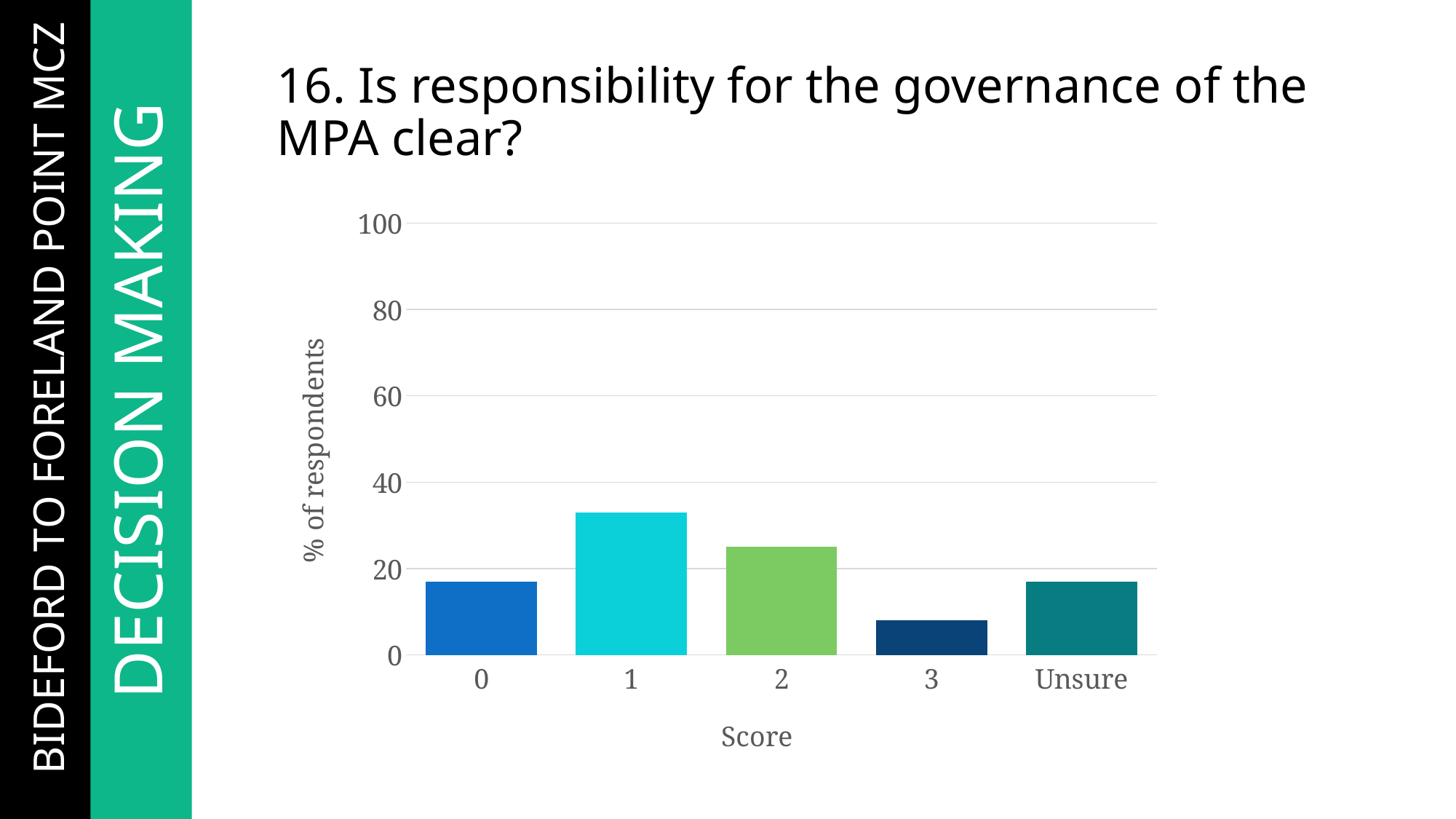
What is the label of the y axis of the chart? % of respondents Is the value for score 2 greater or less than 20? greater How many categories are shown on the x axis of the chart? 5 Is the value for Unsure greater or less than 20? less Is the value for score 3 greater or less than 20? less What kind of chart is shown on the slide? bar chart Which score category has the lowest percentage of respondents? 3 Which is larger, the value for score 1 or the value for score 2? score 1 Which is larger, the value for score 3 or the value for Unsure? Unsure Which score category has the highest percentage of respondents? 1